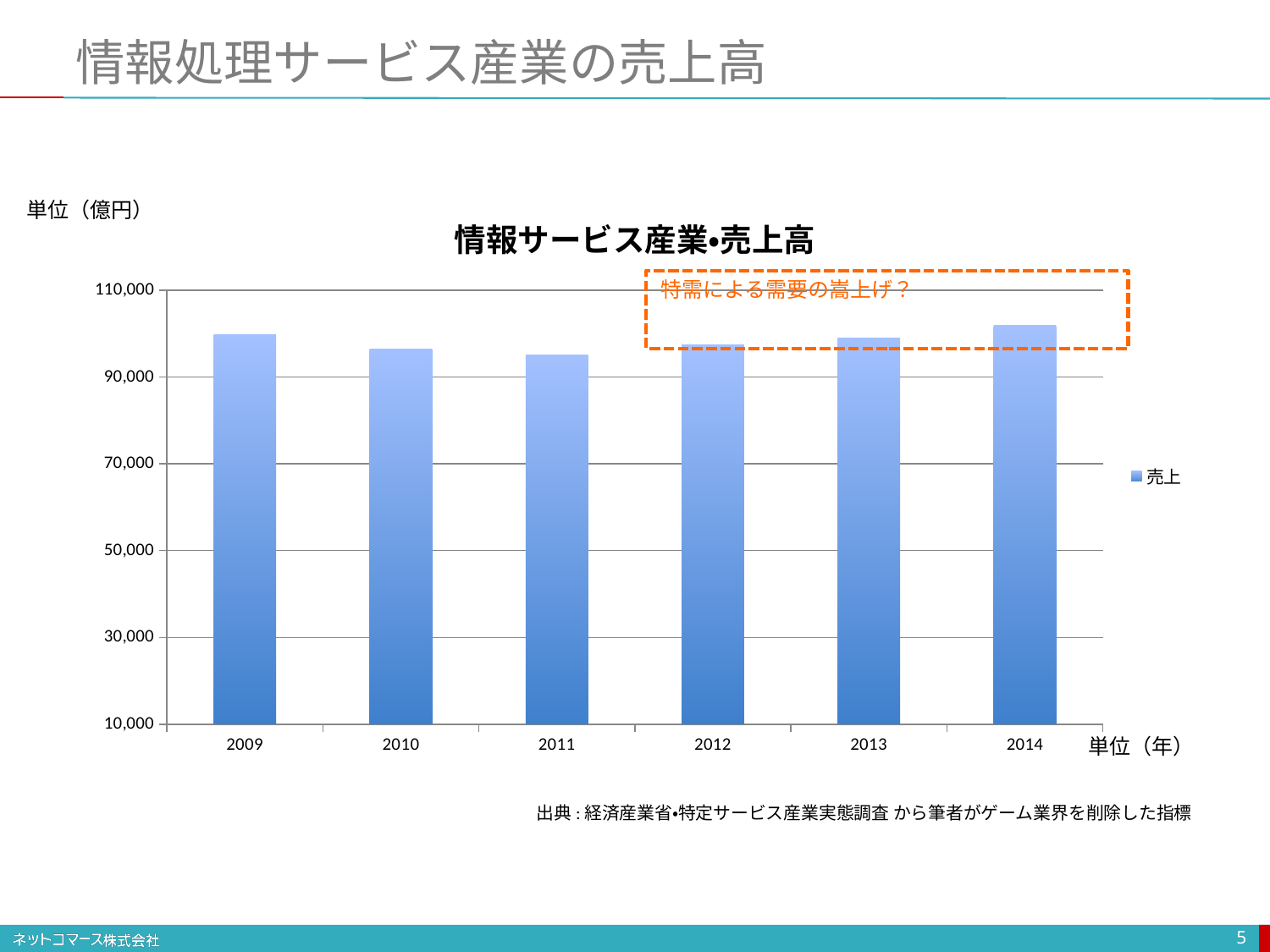
Do the values rise or fall from 2011 to 2014? rise How many years are plotted on the x axis of the chart? 6 Which is larger, the value for 2009 or the value for 2011? 2009 Which year has the highest value in the chart? 2014 Is the value for 2014 greater or less than 90,000? greater Is the value for 2009 greater or less than 70,000? greater How many series does the chart's legend list? 1 What is the title of the chart? 情報サービス産業•売上高 What is the name of the series shown in the chart's legend? 売上 What kind of chart is shown on the slide? bar chart Is the value for 2011 greater or less than 110,000? less Which is larger, the value for 2011 or the value for 2014? 2014